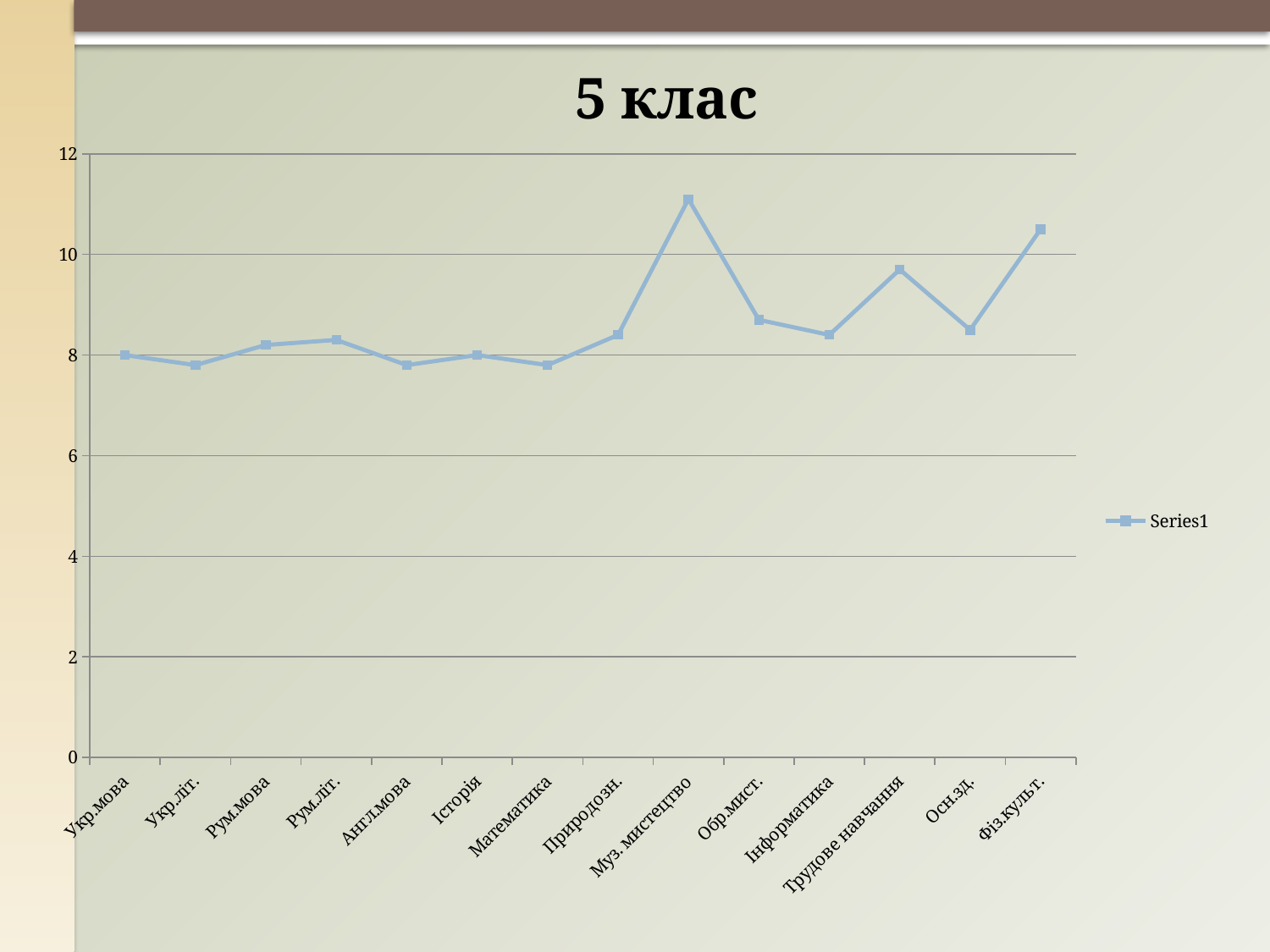
Is the value for Муз. мистецтво greater or less than 10? greater Is the value for Фіз.культ. greater or less than 10? greater What is the title of the chart? 5 клас Is the value for Укр.літ. greater or less than 8? less How many series does the legend list? 1 Which category has the highest value? Муз. мистецтво How many categories are plotted along the x axis? 14 What is the name of the series shown in the legend? Series1 Which is larger, the value for Муз. мистецтво or the value for Обр.мист.? Муз. мистецтво What kind of chart is shown on the slide? line chart Which is larger, the value for Трудове навчання or the value for Осн.зд.? Трудове навчання